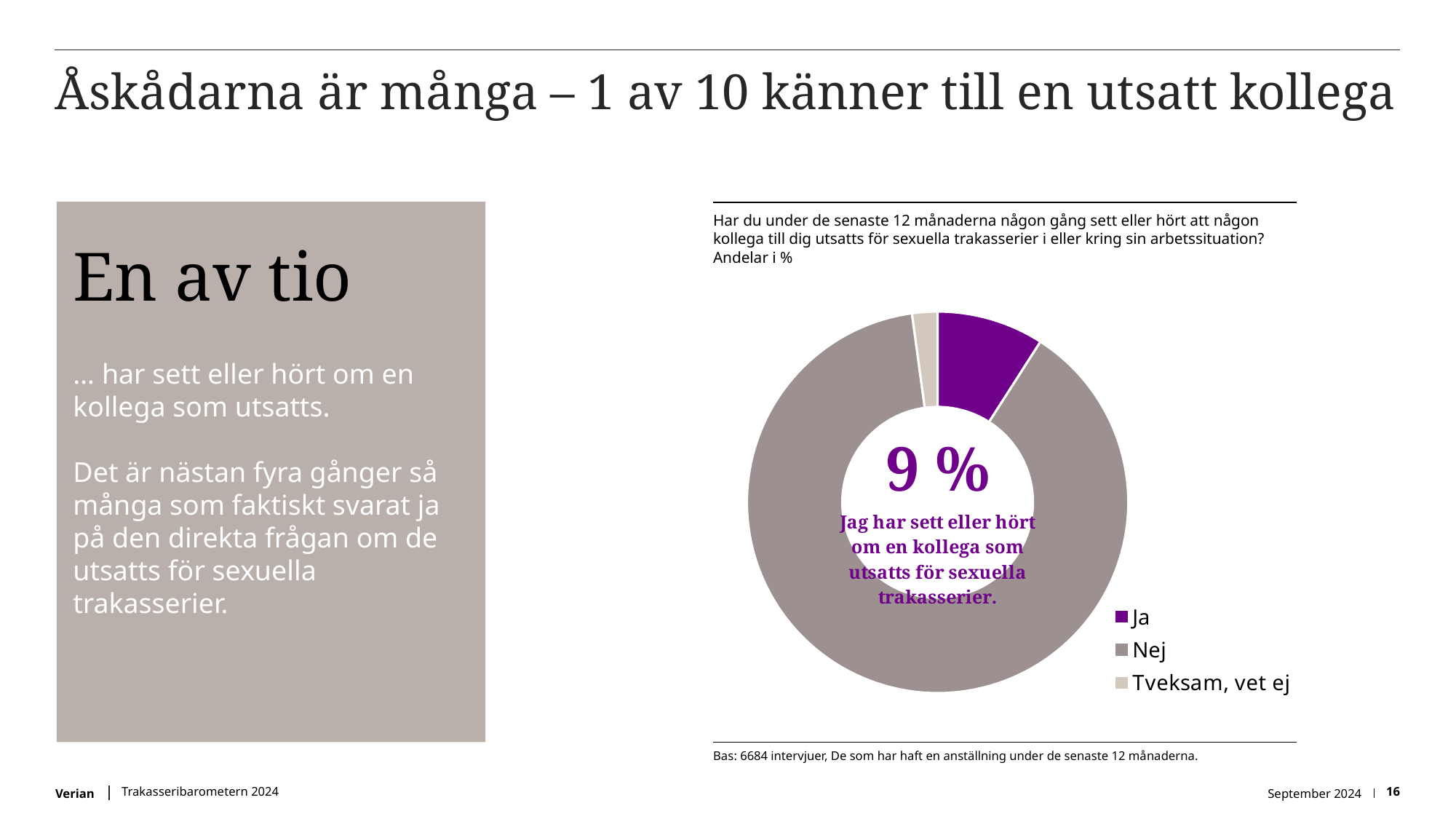
Which category has the smallest slice in the pie chart? Tveksam, vet ej What share of respondents answered "Ja" in the pie chart? 9 % Which slice is larger in the pie chart, "Ja" or "Nej"? Nej Which legend entry is shown in the light beige colour? Tveksam, vet ej Which slice is larger in the pie chart, "Ja" or "Tveksam, vet ej"? Ja What is the percentage printed in the centre of the donut chart? 9 % Which category has the largest slice in the pie chart? Nej What kind of chart is shown on the slide? Doughnut chart How many entries does the legend of the pie chart list? 3 What colour is the "Ja" slice in the pie chart? Purple How many categories does the pie chart show? 3